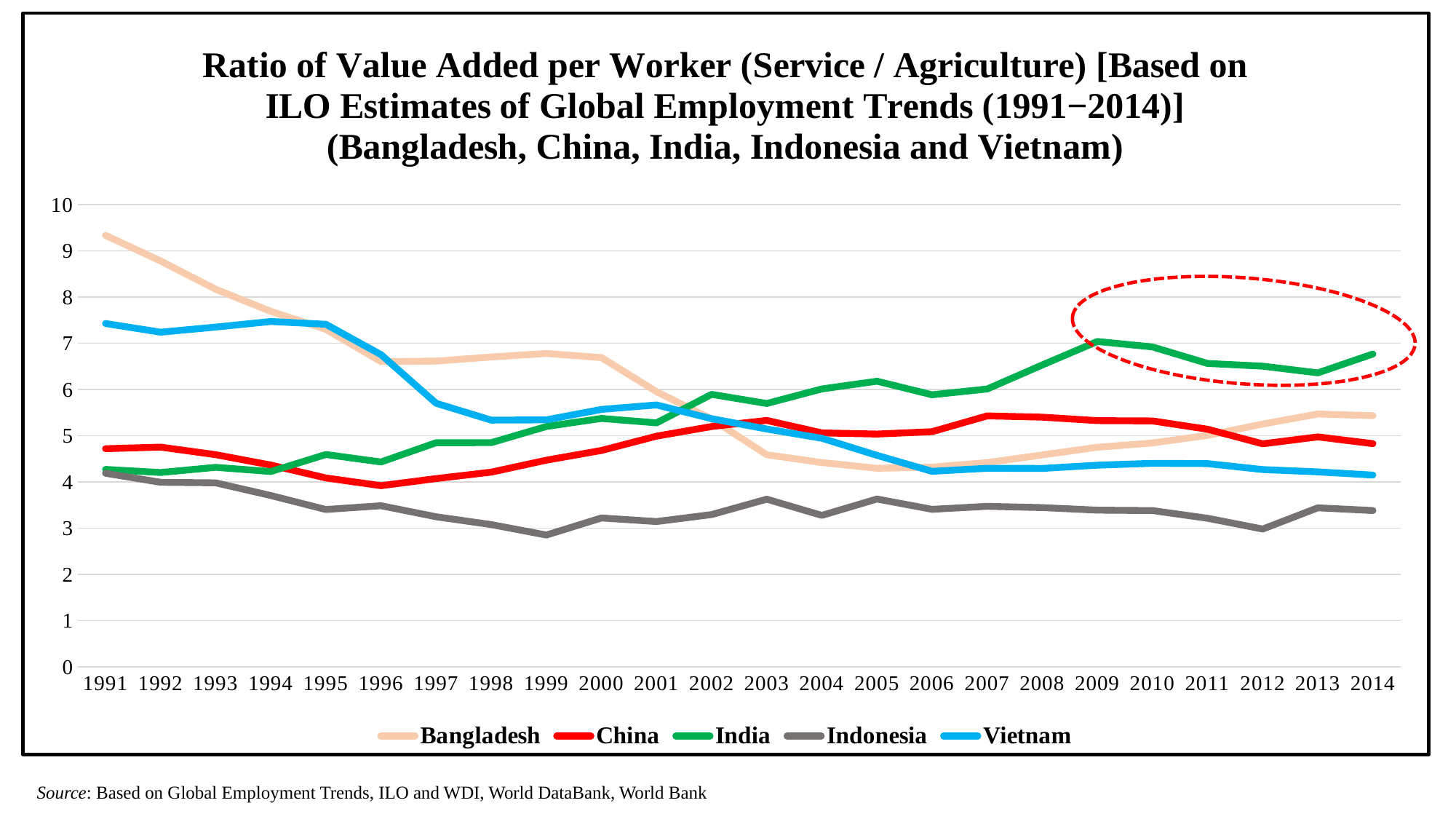
Which country has the lowest ratio in 2014? Indonesia Which country has the highest ratio in 1991? Bangladesh Is the value for Bangladesh in 1991 greater or less than 9? greater Is the value for Indonesia in 1999 greater or less than 3? less What kind of chart is shown on the slide? line chart Does the Bangladesh line rise or fall from 1991 to 2005? fall Which country has the highest ratio in 2014? India How many years are plotted along the x axis? 24 Which country's line is enclosed by the dashed red ellipse? India Is the value for Vietnam in 1991 greater or less than 7? greater In 1995, which is larger: the value for Vietnam or the value for China? Vietnam How many series does the legend list? 5